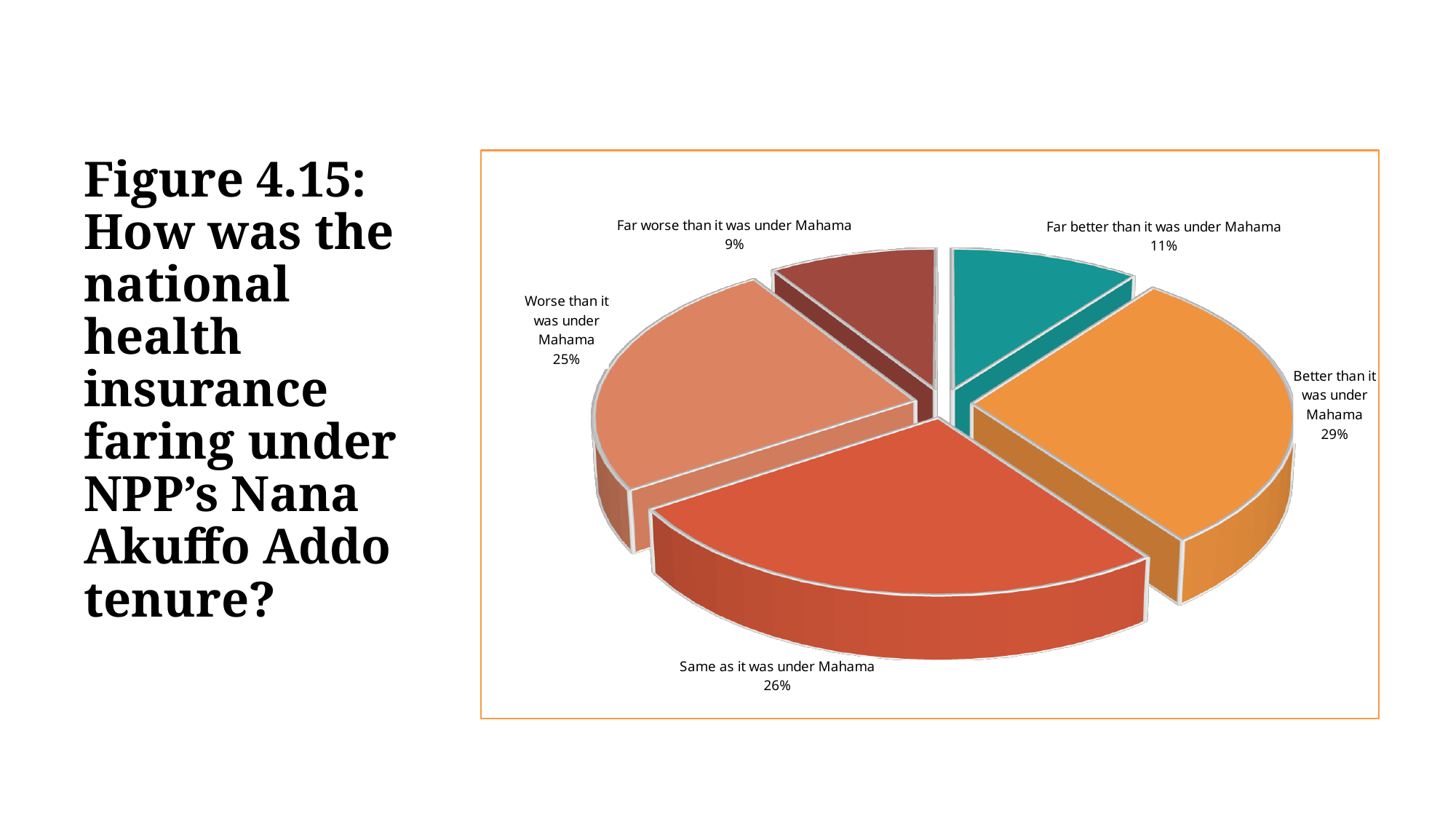
What is the figure number given in the slide title? Figure 4.15 What is the difference in percentage points between 'Better than it was under Mahama' and 'Far better than it was under Mahama'? 18 Which response category has the largest share of the pie? Better than it was under Mahama What percentage of respondents said the national health insurance was better than it was under Mahama? 29% What percentage of respondents said it was far better than it was under Mahama? 11% What share of the pie is labelled 'Same as it was under Mahama'? 26% What is the combined percentage of respondents who said it was worse or far worse than under Mahama? 34% What kind of chart is shown on the slide? Pie chart Which response category has the smallest share of the pie? Far worse than it was under Mahama What percentage of respondents said the national health insurance was far worse than it was under Mahama? 9% Which is larger: the share for 'Worse than it was under Mahama' or the share for 'Far worse than it was under Mahama'? Worse than it was under Mahama How many slices does the pie chart have? 5